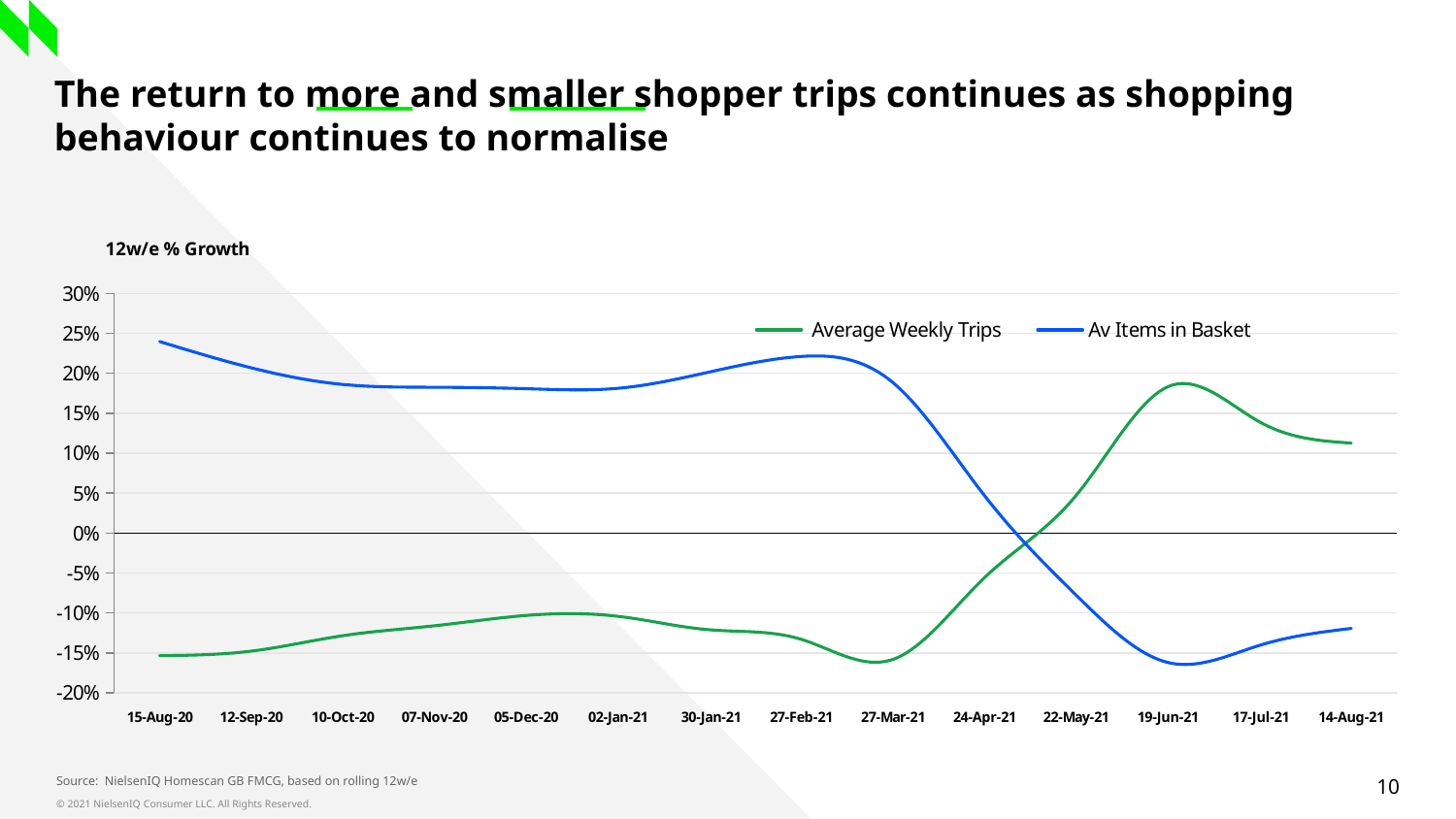
What kind of chart is shown on the slide? line chart Does the Av Items in Basket line rise or fall between 27-Feb-21 and 19-Jun-21? fall Is the value for Av Items in Basket at 19-Jun-21 greater or less than -10%? less How many dates are shown along the x axis? 14 What is the title shown above the chart? 12w/e % Growth Is the value for Av Items in Basket at 15-Aug-20 greater or less than 20%? greater Which colour is used for the Av Items in Basket line? blue How many series does the legend list? 2 Which series reaches the highest value anywhere on the chart? Av Items in Basket At 14-Aug-21, which series has the higher value, Average Weekly Trips or Av Items in Basket? Average Weekly Trips Is the value for Average Weekly Trips at 15-Aug-20 greater or less than -10%? less